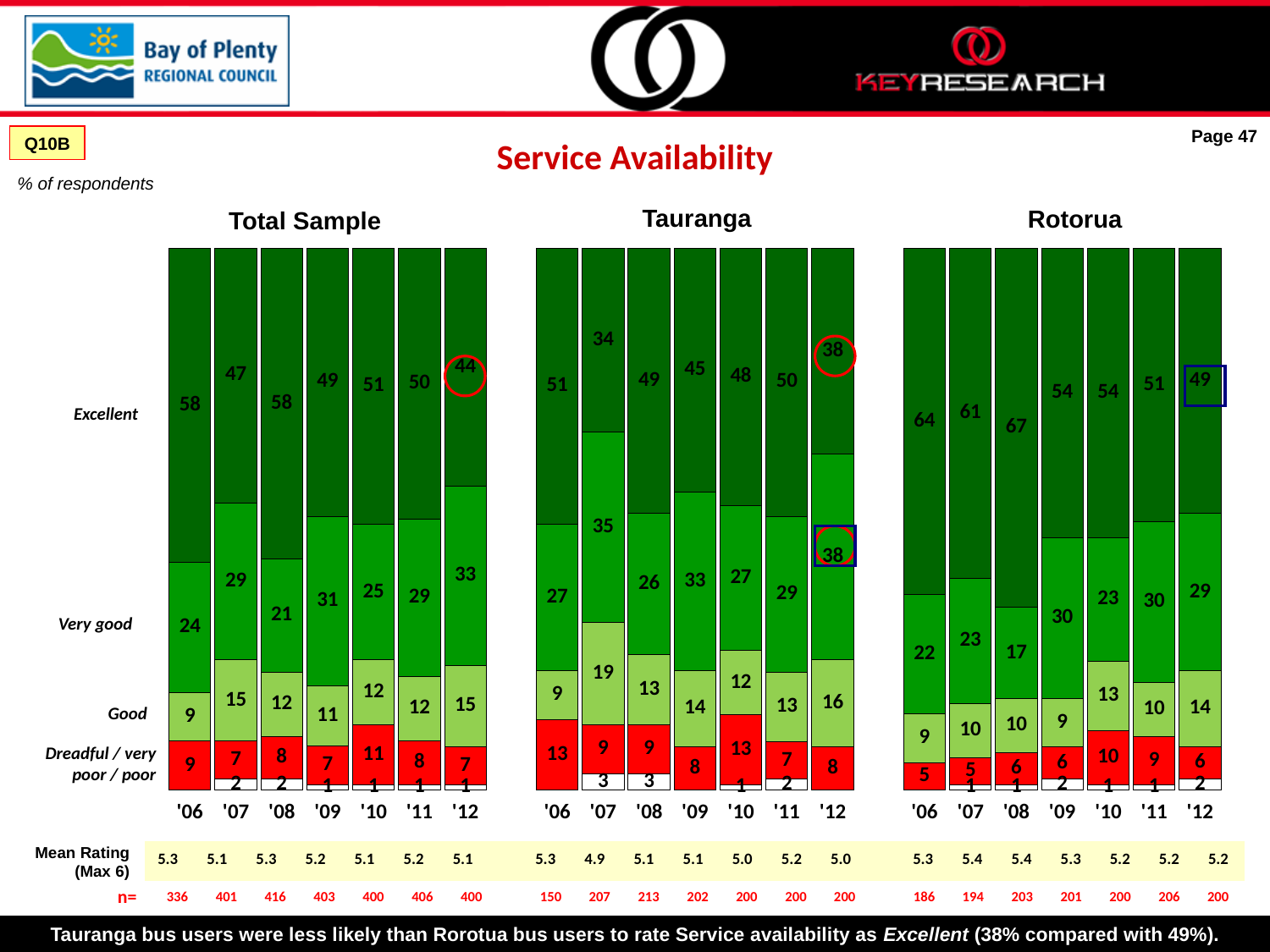
What is the sample size (n) for the Total Sample in '08? 416 In the Tauranga chart, which year has the lowest Excellent percentage? '07 In the Rotorua chart, what is the Good percentage in '10? 13 What is the difference between the Rotorua and Tauranga Excellent percentages in '12? 11 What type of chart is used to show the Rotorua results? Stacked bar chart In the Rotorua chart, which year has the highest Excellent percentage? '08 What is the title of the slide's charts? Service Availability How many years are shown on the x axis of the Tauranga chart? 7 In the Total Sample chart, what percentage of respondents rated service availability as Excellent in '12? 44 In the Total Sample chart, is the Very good percentage larger in '12 or in '06? '12 In the Tauranga chart, what percentage rated service availability as Very good in '07? 35 What is the mean rating for Tauranga in '07? 4.9